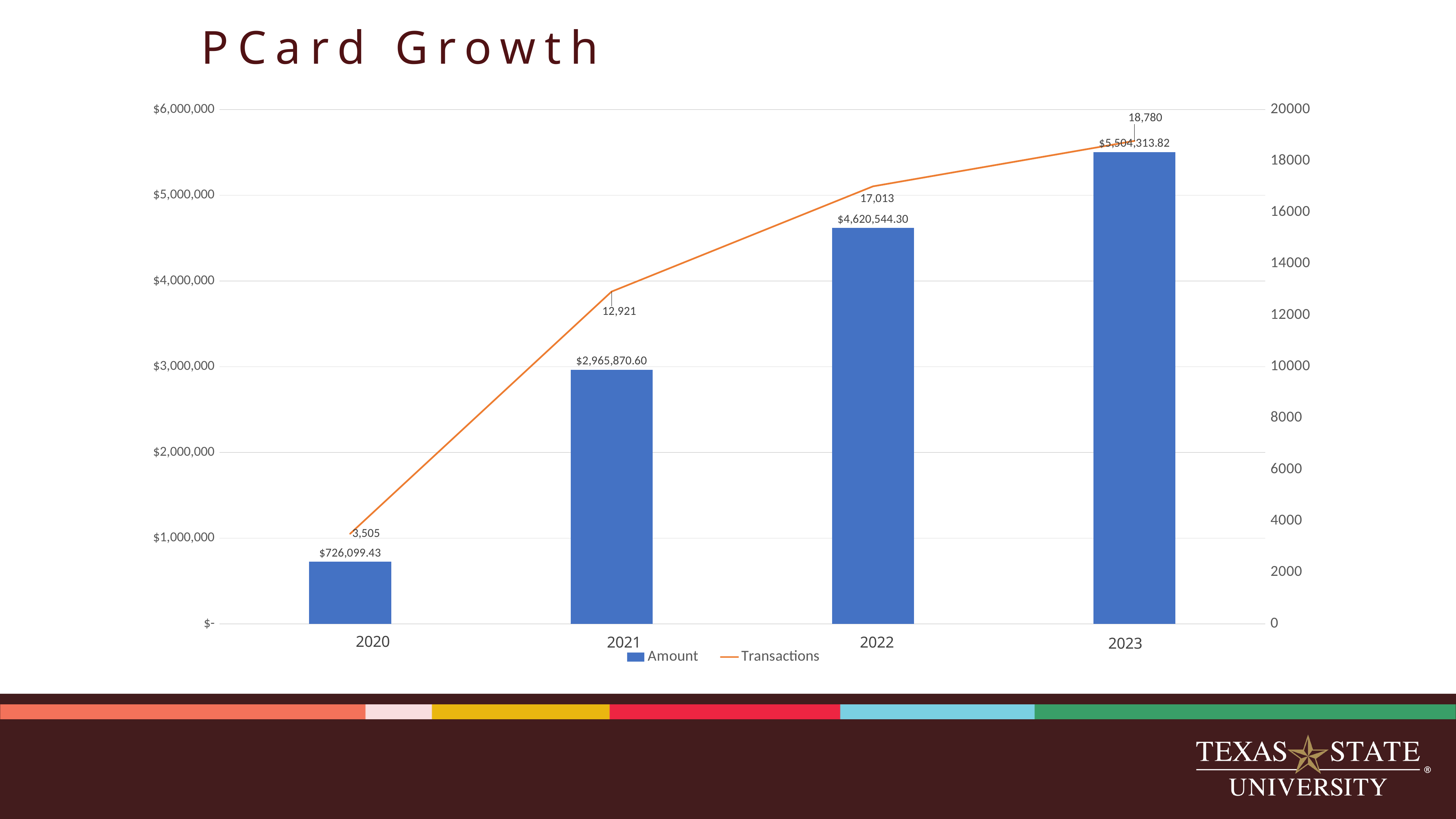
How many years are shown on the x axis? 4 Which is larger, the Amount for 2021 or the Amount for 2022? 2022 Which year has the lowest number of Transactions? 2020 Is the Amount for 2022 greater or less than $4,000,000? greater How many Transactions are shown for 2022? 17,013 Which year has the highest Amount? 2023 Do the Transactions values rise or fall from 2020 to 2023? rise How many series does the legend list? 2 What is the Amount value for 2021? $2,965,870.60 What is the difference in Transactions between 2023 and 2022? 1,767 What is the difference in Amount between 2023 and 2022? $883,769.52 What is the Amount value for 2020? $726,099.43